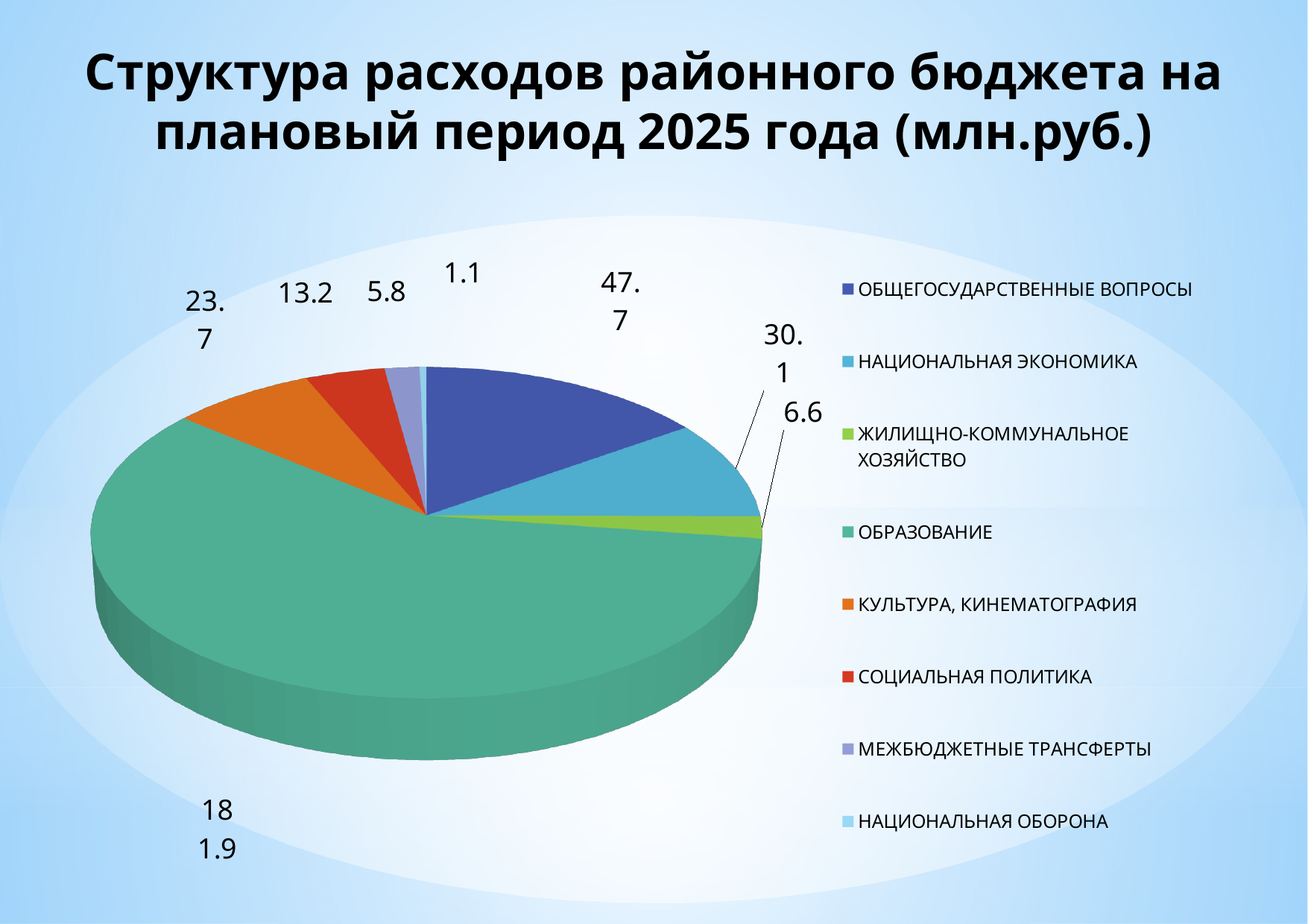
How many categories does the legend list? 8 What is the value for НАЦИОНАЛЬНАЯ ОБОРОНА? 1.1 What is the value for КУЛЬТУРА, КИНЕМАТОГРАФИЯ? 23.7 What is the difference between the values for ОБЩЕГОСУДАРСТВЕННЫЕ ВОПРОСЫ and НАЦИОНАЛЬНАЯ ЭКОНОМИКА? 17.6 Which category has the smallest slice of the pie? НАЦИОНАЛЬНАЯ ОБОРОНА What is the value for ОБЩЕГОСУДАРСТВЕННЫЕ ВОПРОСЫ? 47.7 What is the value for НАЦИОНАЛЬНАЯ ЭКОНОМИКА? 30.1 Which is larger, the value for ЖИЛИЩНО-КОММУНАЛЬНОЕ ХОЗЯЙСТВО or the value for МЕЖБЮДЖЕТНЫЕ ТРАНСФЕРТЫ? ЖИЛИЩНО-КОММУНАЛЬНОЕ ХОЗЯЙСТВО What is the value for ОБРАЗОВАНИЕ? 181.9 Which category has the largest slice of the pie? ОБРАЗОВАНИЕ What is the value for СОЦИАЛЬНАЯ ПОЛИТИКА? 13.2 What kind of chart is shown on the slide? pie chart